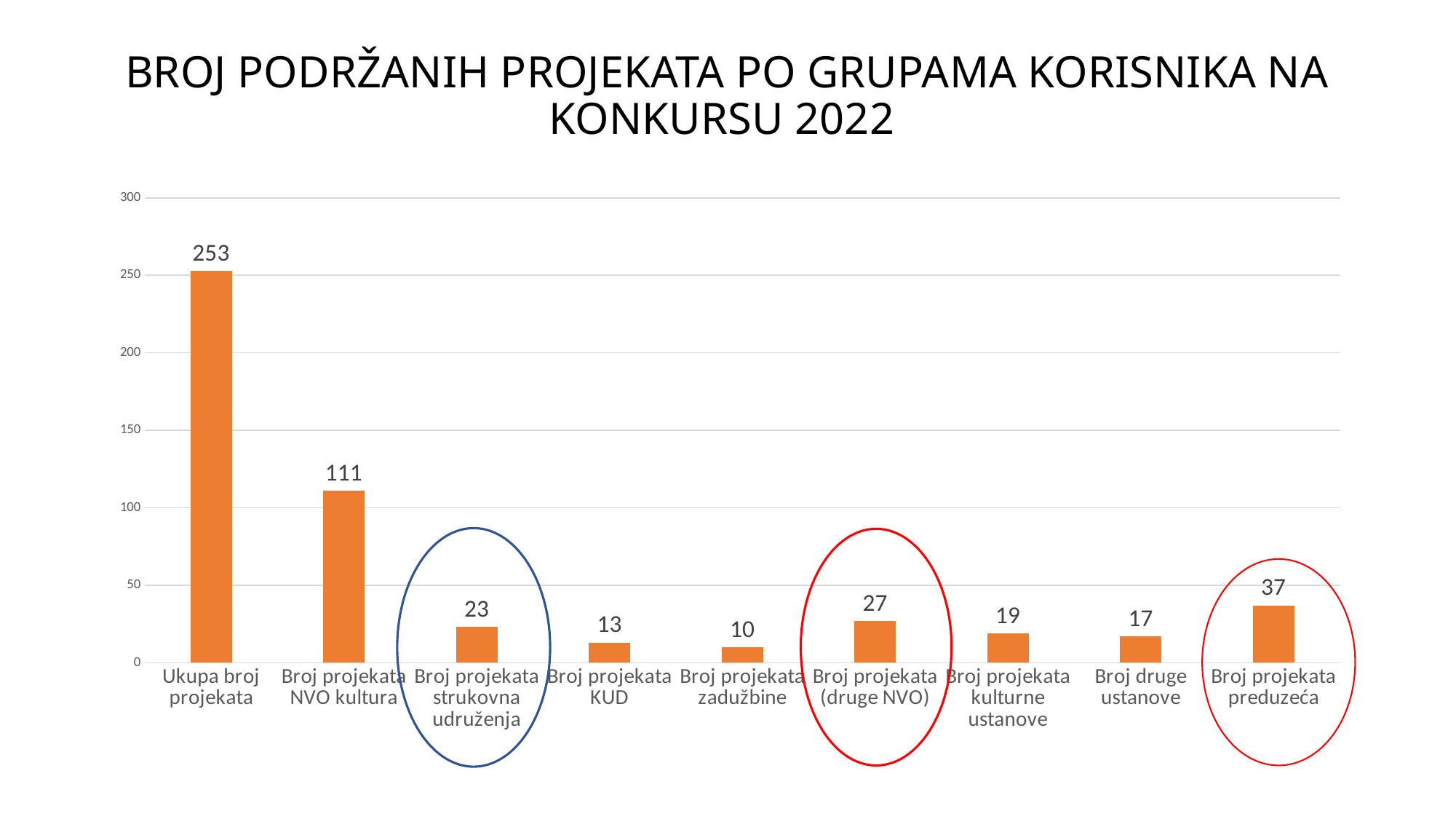
Which category has the highest value? Ukupa broj projekata What is the title of the chart? BROJ PODRŽANIH PROJEKATA PO GRUPAMA KORISNIKA NA KONKURSU 2022 What is the value for Broj projekata NVO kultura? 111 Which is larger, Broj projekata kulturne ustanove or Broj druge ustanove? Broj projekata kulturne ustanove What kind of chart is shown on the slide? bar chart Is the value for Broj projekata NVO kultura greater or less than 100? greater What is the difference between Broj projekata (druge NVO) and Broj projekata strukovna udruženja? 4 What is the value for Broj projekata preduzeća? 37 Which category has the lowest value? Broj projekata zadužbine What is the value for Ukupa broj projekata? 253 How many categories are shown on the x axis? 9 What is the value for Broj projekata zadužbine? 10